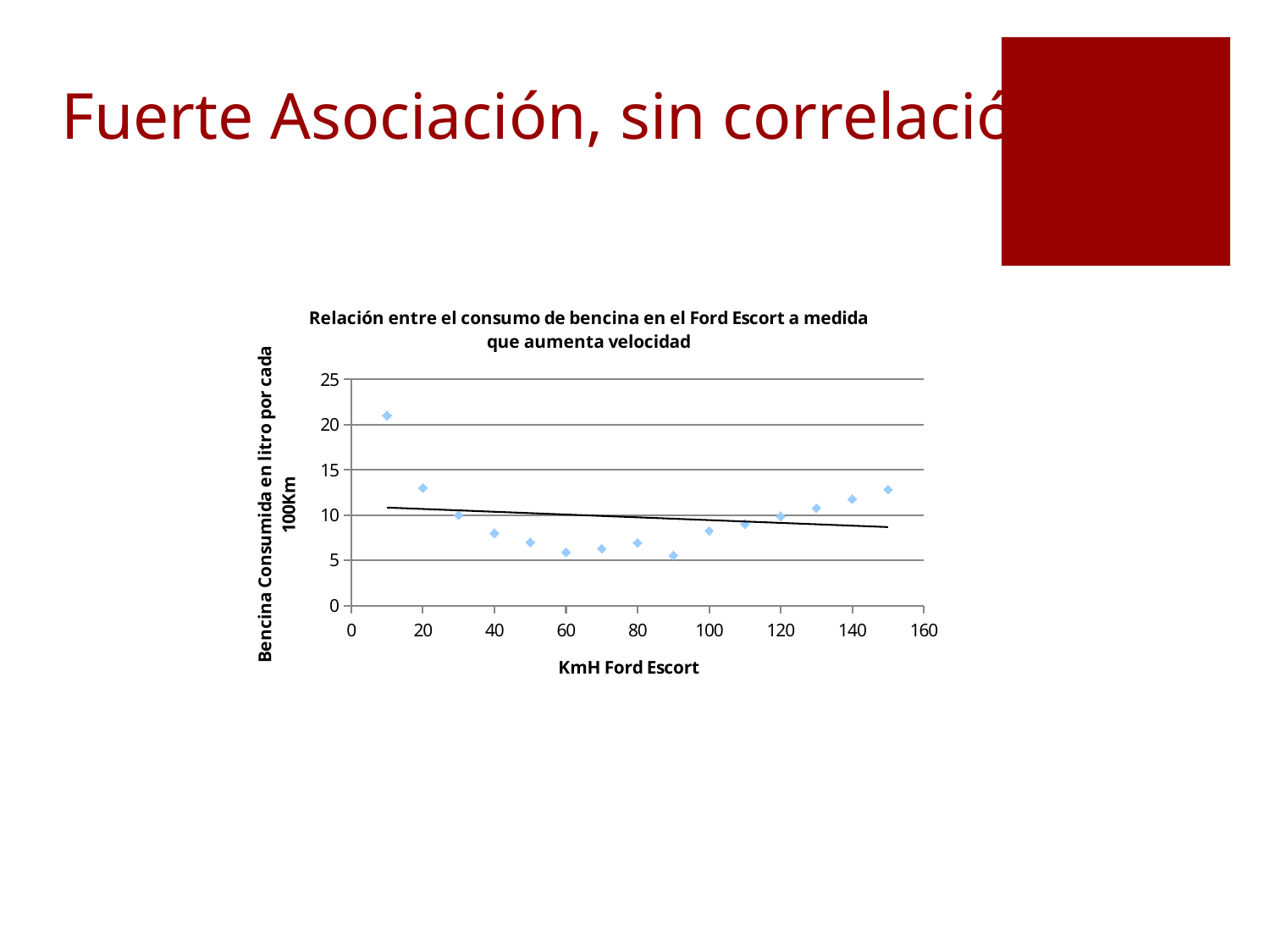
How many data points are plotted in the chart? 15 Is the fuel consumption at 20 KmH greater or less than 10? greater Is the fuel consumption at 90 KmH greater or less than 10? less What is the label of the x axis of the chart? KmH Ford Escort What kind of chart is shown on the slide? Scatter chart Is the fuel consumption at 150 KmH greater or less than 10? greater Do the plotted values rise or fall as speed increases from 10 KmH to 60 KmH? fall Which has higher fuel consumption, 10 KmH or 150 KmH? 10 KmH At which KmH value is the fuel consumption highest? 10 Do the plotted values rise or fall as speed increases from 90 KmH to 150 KmH? rise